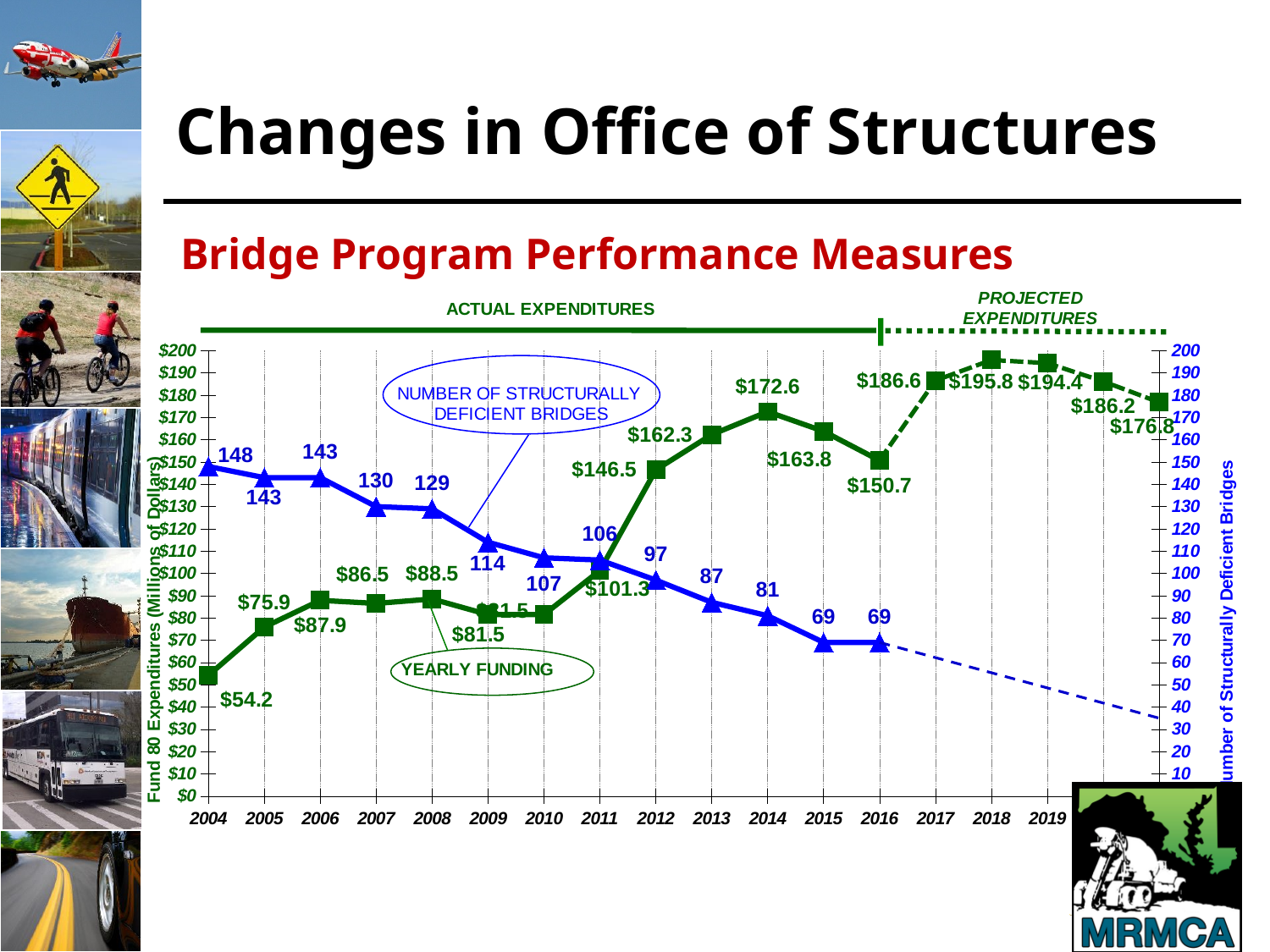
Does the number of structurally deficient bridges rise or fall from 2004 to 2016? fall What is the difference between the yearly funding in 2014 and in 2013? $10.3 By how much did the number of structurally deficient bridges fall from 2004 to 2016? 79 How many structurally deficient bridges were there in 2004? 148 In which year was the number of structurally deficient bridges highest? 2004 What type of chart is used for the Bridge Program Performance Measures? line chart What does the dotted green portion of the line at the top of the chart represent? Projected Expenditures What was the yearly funding in 2004? $54.2 What was the yearly funding in 2014? $172.6 Which year had higher yearly funding, 2012 or 2013? 2013 In which year was the yearly funding lowest? 2004 How many structurally deficient bridges were there in 2016? 69